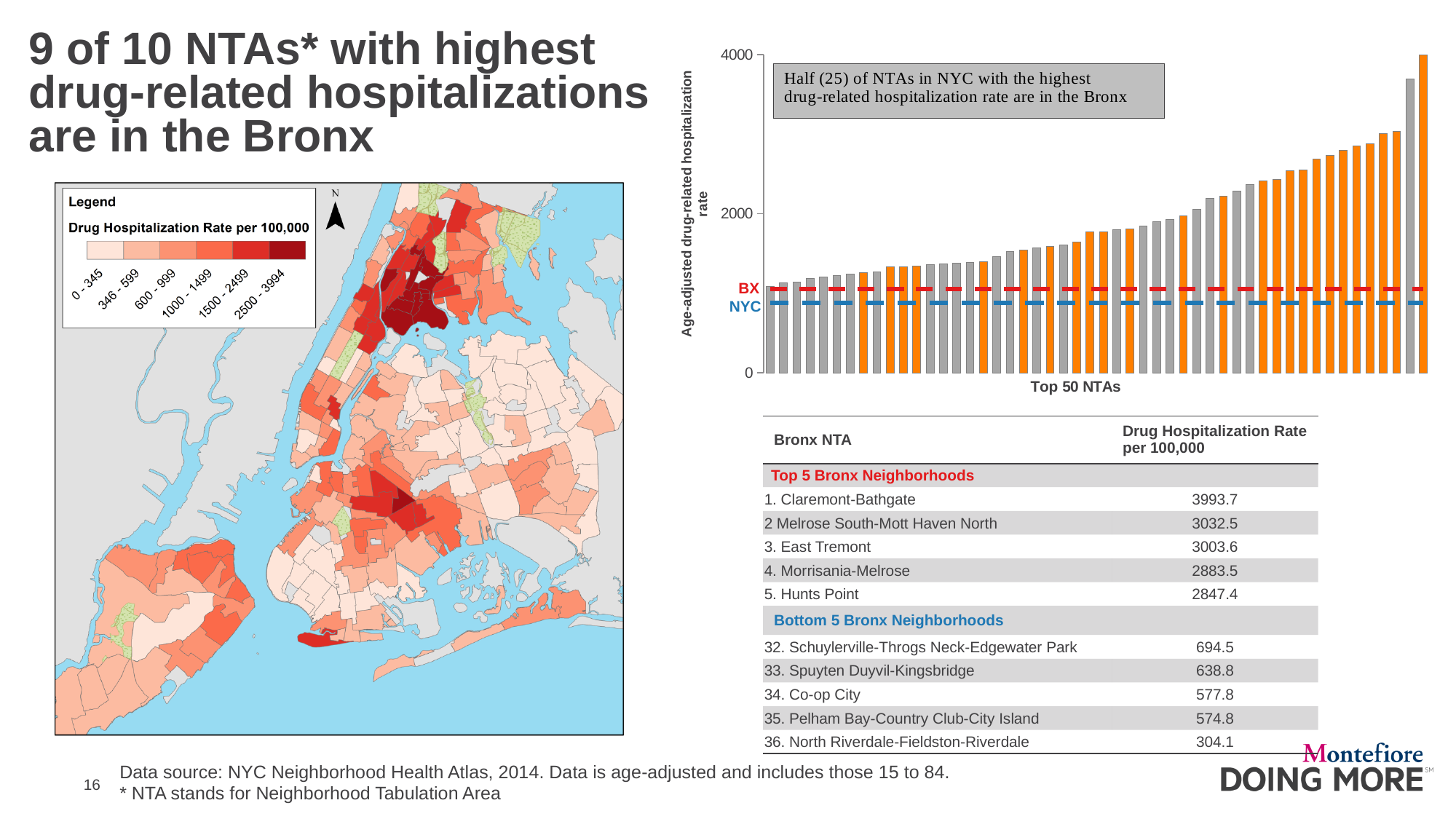
In the bar chart, which dashed reference line is higher, BX or NYC? BX How many NTAs (bars) are plotted in the bar chart? 50 In the table, what is the drug hospitalization rate per 100,000 for Claremont-Bathgate? 3993.7 What kind of chart is shown in the top right of the slide? bar chart What is the y-axis label of the bar chart? Age-adjusted drug-related hospitalization rate Do the bar values in the bar chart rise or fall from left to right? rise In the bar chart, is the value of the shortest bar greater or less than 2000? less In the table, what is the difference between the rates for Claremont-Bathgate (3993.7) and North Riverdale-Fieldston-Riverdale (304.1)? 3689.6 According to the text box on the bar chart, how many of the top 50 NTAs are in the Bronx? 25 What is the x-axis label of the bar chart? Top 50 NTAs In the bar chart, is the value of the tallest bar greater or less than 3000? greater